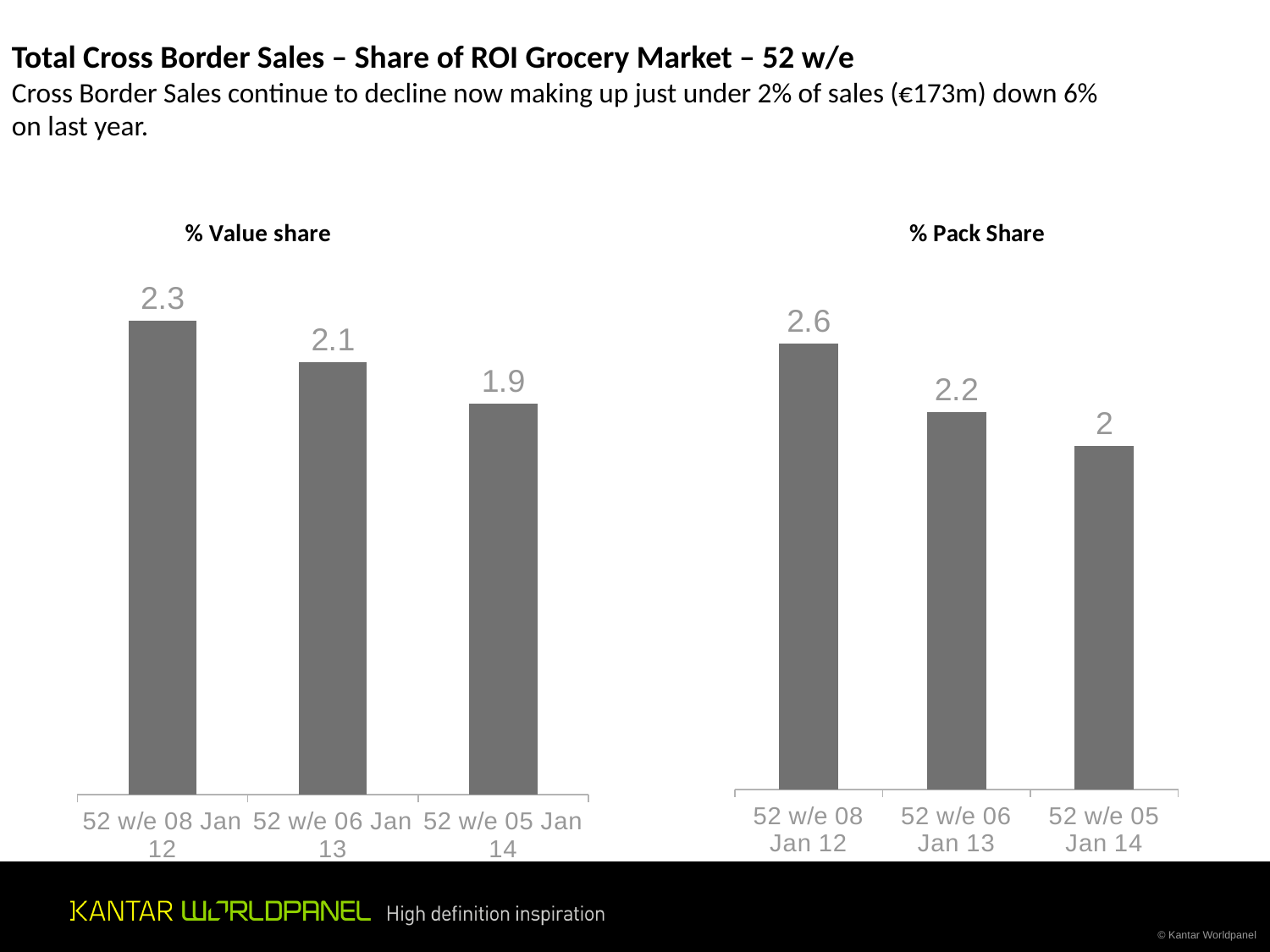
In the % Pack Share chart, which is larger: the value for 52 w/e 08 Jan 12 or 52 w/e 05 Jan 14? 52 w/e 08 Jan 12 In the % Pack Share chart, what is the value for 52 w/e 06 Jan 13? 2.2 In the % Pack Share chart, which period has the lowest value? 52 w/e 05 Jan 14 In the % Value share chart, what is the value for 52 w/e 08 Jan 12? 2.3 In the % Value share chart, what is the difference between the values for 52 w/e 08 Jan 12 and 52 w/e 05 Jan 14? 0.4 In the % Pack Share chart, what is the value for 52 w/e 05 Jan 14? 2 In the % Value share chart, which period has the highest value? 52 w/e 08 Jan 12 In the % Value share chart, do the values rise or fall from left to right? Fall In the % Pack Share chart, what is the difference between the values for 52 w/e 08 Jan 12 and 52 w/e 06 Jan 13? 0.4 In the % Value share chart, what is the value for 52 w/e 05 Jan 14? 1.9 What type of chart is the % Pack Share chart? Bar chart How many bars are in the % Value share chart? 3